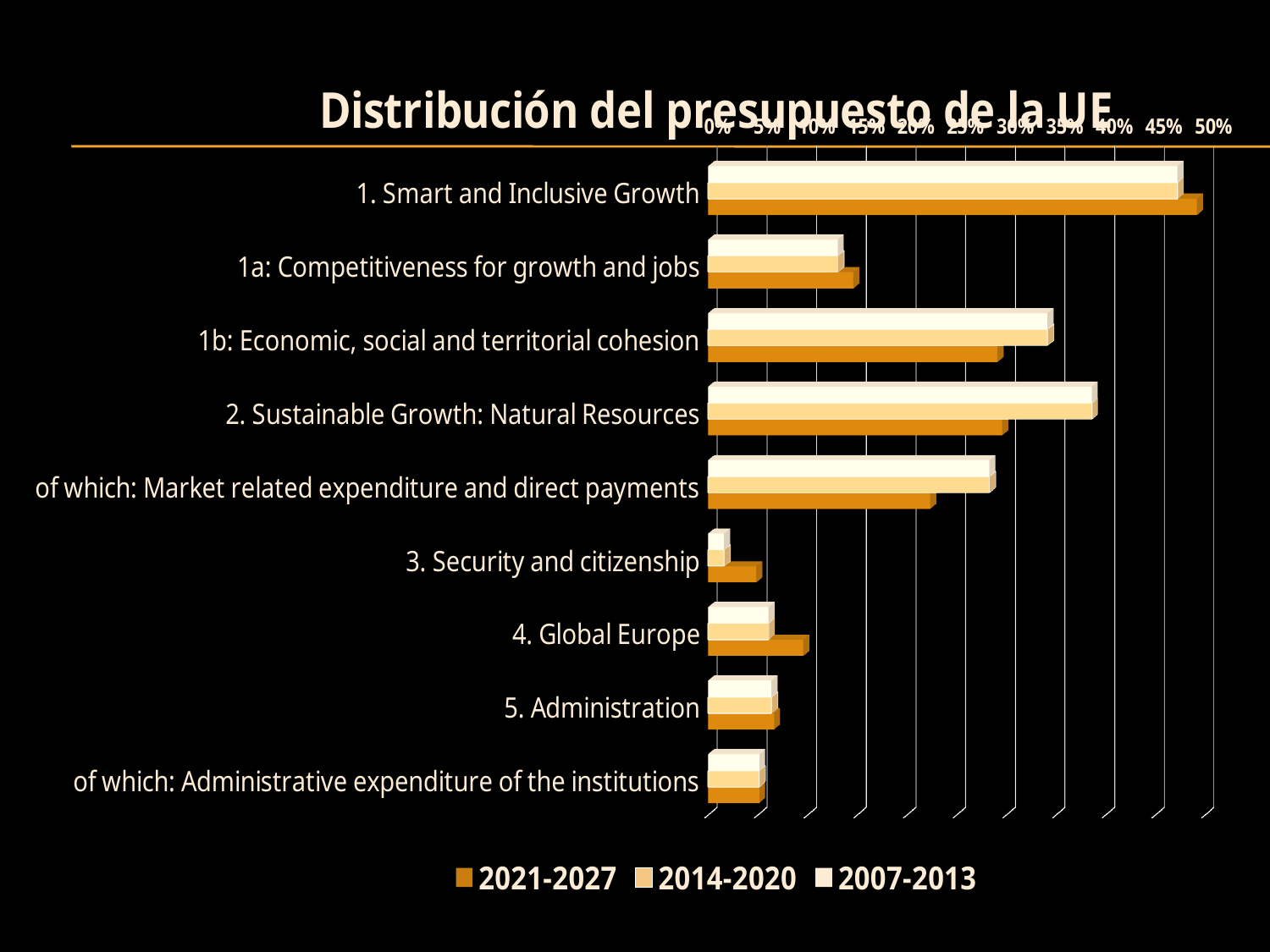
Is the 2021-2027 value for 1. Smart and Inclusive Growth greater or less than 45%? greater For 1b: Economic, social and territorial cohesion, which is larger: the 2021-2027 value or the 2014-2020 value? 2014-2020 How many series does the legend list? 3 Which periods are listed in the legend? 2021-2027, 2014-2020, 2007-2013 What kind of chart is shown on the slide? Bar chart For 4. Global Europe, which is larger: the 2021-2027 value or the 2007-2013 value? 2021-2027 Which category has the highest value for the 2021-2027 series? 1. Smart and Inclusive Growth What is the title of the chart? Distribución del presupuesto de la UE How many categories are plotted on the chart? 9 Which category has the lowest value for the 2014-2020 series? 3. Security and citizenship Is the 2021-2027 value for 'of which: Market related expenditure and direct payments' greater or less than 25%? less Is the 2014-2020 value for 2. Sustainable Growth: Natural Resources greater or less than 35%? greater